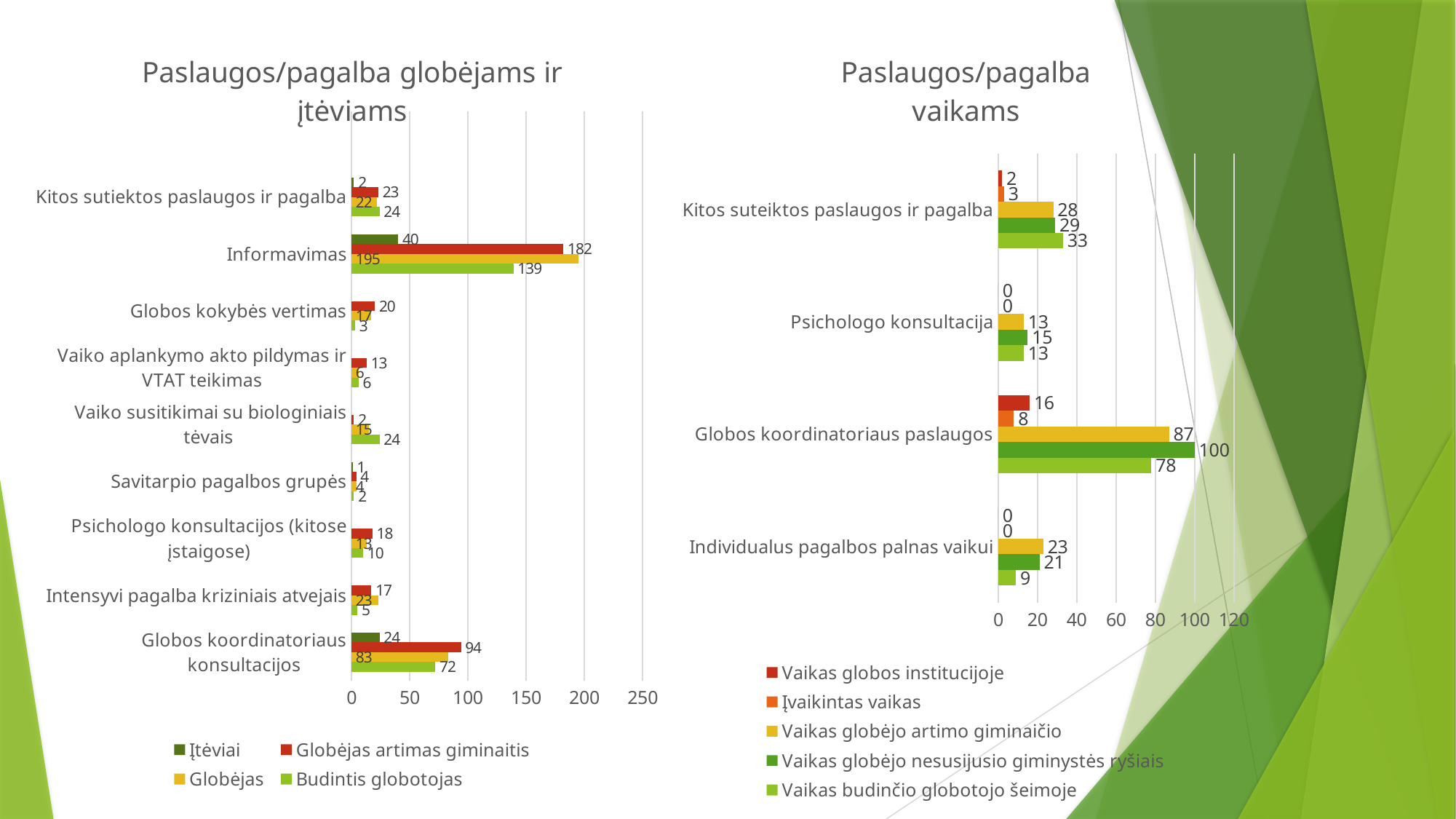
In the chart 'Paslaugos/pagalba vaikams', what is the value for Vaikas budinčio globotojo šeimoje in the Individualus pagalbos palnas vaikui category? 9 In the chart 'Paslaugos/pagalba globėjams ir įtėviams', what is the value for Globėjas in the Informavimas category? 195 In the chart 'Paslaugos/pagalba globėjams ir įtėviams', how many series does the legend list? 4 In the chart 'Paslaugos/pagalba vaikams', which is larger for Kitos suteiktos paslaugos ir pagalba: Vaikas globėjo artimo giminaičio or Vaikas budinčio globotojo šeimoje? Vaikas budinčio globotojo šeimoje In the chart 'Paslaugos/pagalba vaikams', what is the value for Vaikas globėjo nesusijusio giminystės ryšiais in the Globos koordinatoriaus paslaugos category? 100 In the chart 'Paslaugos/pagalba globėjams ir įtėviams', which category has the highest value for Budintis globotojas? Informavimas In the chart 'Paslaugos/pagalba globėjams ir įtėviams', how many categories are shown on the vertical axis? 9 In the chart 'Paslaugos/pagalba vaikams', what is the difference between the Vaikas globėjo artimo giminaičio and Įvaikintas vaikas values for Globos koordinatoriaus paslaugos? 79 In the chart 'Paslaugos/pagalba globėjams ir įtėviams', what is the difference between the Globėjas artimas giminaitis and Budintis globotojas values for Informavimas? 43 What type of chart is 'Paslaugos/pagalba vaikams'? Bar chart In the chart 'Paslaugos/pagalba globėjams ir įtėviams', what is the value for Globėjas artimas giminaitis in the Globos koordinatoriaus konsultacijos category? 94 In the chart 'Paslaugos/pagalba vaikams', how many series does the legend list? 5